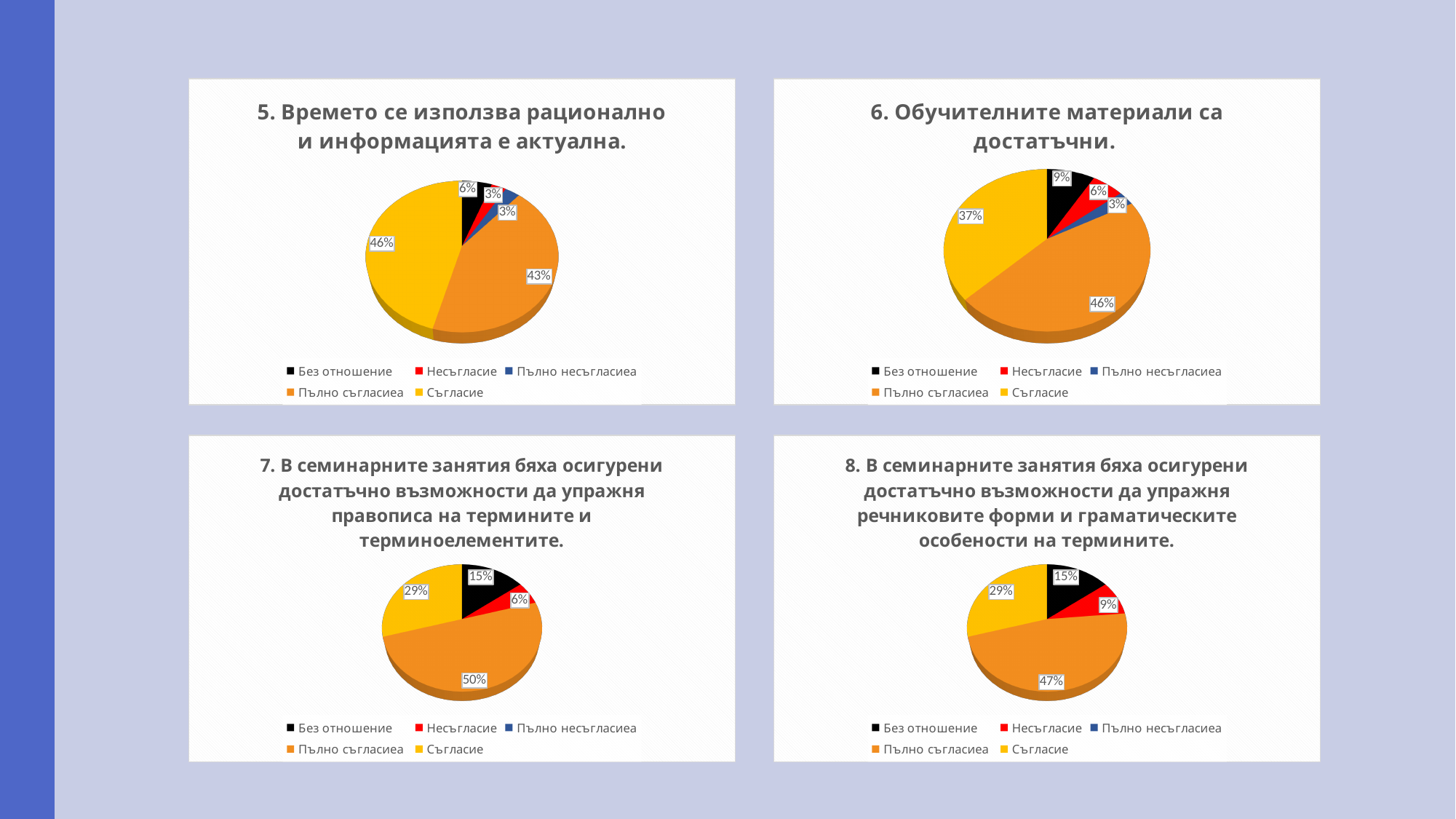
In the chart titled "5. Времето се използва рационално и информацията е актуална.", what percentage is shown for Пълно съгласиеа? 43% In the chart titled "6. Обучителните материали са достатъчни.", which category has the largest slice? Пълно съгласиеа In the chart titled "8. В семинарните занятия бяха осигурени достатъчно възможности да упражня речниковите форми и граматическите особености на термините.", which is larger: the Без отношение slice or the Съгласие slice? Съгласие In the chart titled "8. В семинарните занятия бяха осигурени достатъчно възможности да упражня речниковите форми и граматическите особености на термините.", what is the difference between the Пълно съгласиеа and Съгласие slices? 18% In the chart titled "6. Обучителните материали са достатъчни.", what percentage is shown for Без отношение? 9% How many entries does the legend list in the chart titled "5. Времето се използва рационално и информацията е актуална."? 5 In the chart titled "6. Обучителните материали са достатъчни.", what is the difference between the Пълно съгласиеа and Съгласие slices? 9% What type of chart is the chart titled "6. Обучителните материали са достатъчни."? Pie chart In the chart titled "8. В семинарните занятия бяха осигурени достатъчно възможности да упражня речниковите форми и граматическите особености на термините.", what percentage is shown for Несъгласие? 9% In the chart titled "7. В семинарните занятия бяха осигурени достатъчно възможности да упражня правописа на термините и терминоелементите.", what percentage is shown for Пълно съгласиеа? 50% In the chart titled "5. Времето се използва рационално и информацията е актуална.", what percentage is shown for Съгласие? 46% In the chart titled "7. В семинарните занятия бяха осигурени достатъчно възможности да упражня правописа на термините и терминоелементите.", which labelled slice is the smallest? Несъгласие